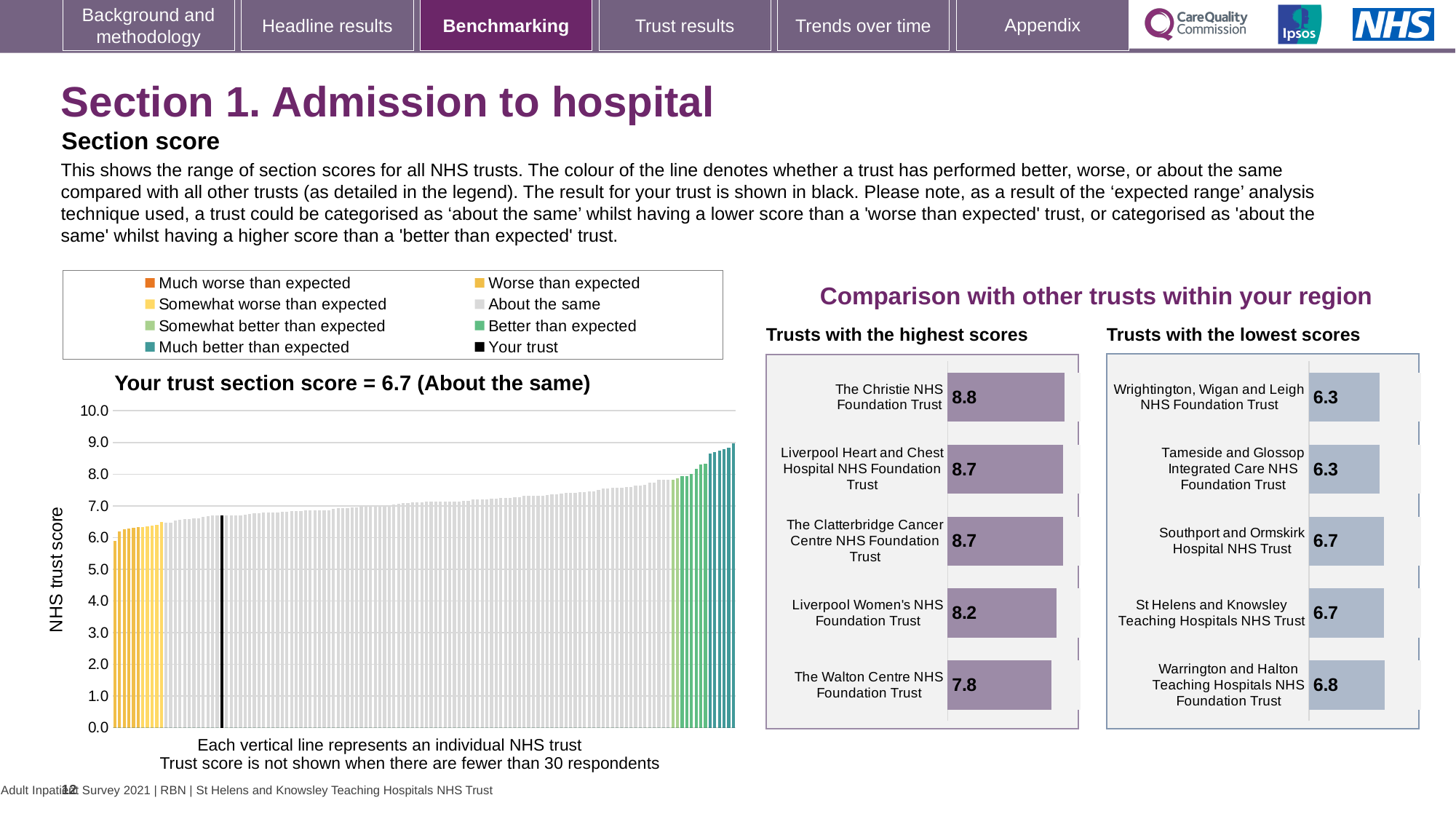
In the 'Trusts with the highest scores' chart, which trust has the lowest score? The Walton Centre NHS Foundation Trust In the 'Trusts with the lowest scores' chart, which trust has the highest score? Warrington and Halton Teaching Hospitals NHS Foundation Trust How many entries does the legend above the 'Your trust section score' chart list? 8 In the 'Trusts with the lowest scores' chart, what is the score for St Helens and Knowsley Teaching Hospitals NHS Trust? 6.7 In the 'Your trust section score' chart on the left, is the value of the leftmost (lowest) bar greater or less than 7.0? less How many trusts are shown in the 'Trusts with the highest scores' chart? 5 In the 'Trusts with the lowest scores' chart, which has the larger score: Warrington and Halton Teaching Hospitals NHS Foundation Trust or Wrightington, Wigan and Leigh NHS Foundation Trust? Warrington and Halton Teaching Hospitals NHS Foundation Trust In the 'Your trust section score' chart on the left, do the bars rise or fall from left to right? rise In the 'Trusts with the highest scores' chart, what is the difference between the scores of The Christie NHS Foundation Trust and The Walton Centre NHS Foundation Trust? 1.0 In the 'Trusts with the highest scores' chart, what is the score for The Christie NHS Foundation Trust? 8.8 What kind of chart is the 'Your trust section score' chart on the left of the slide? bar chart In the 'Your trust section score' chart on the left, what is the section score for your trust? 6.7